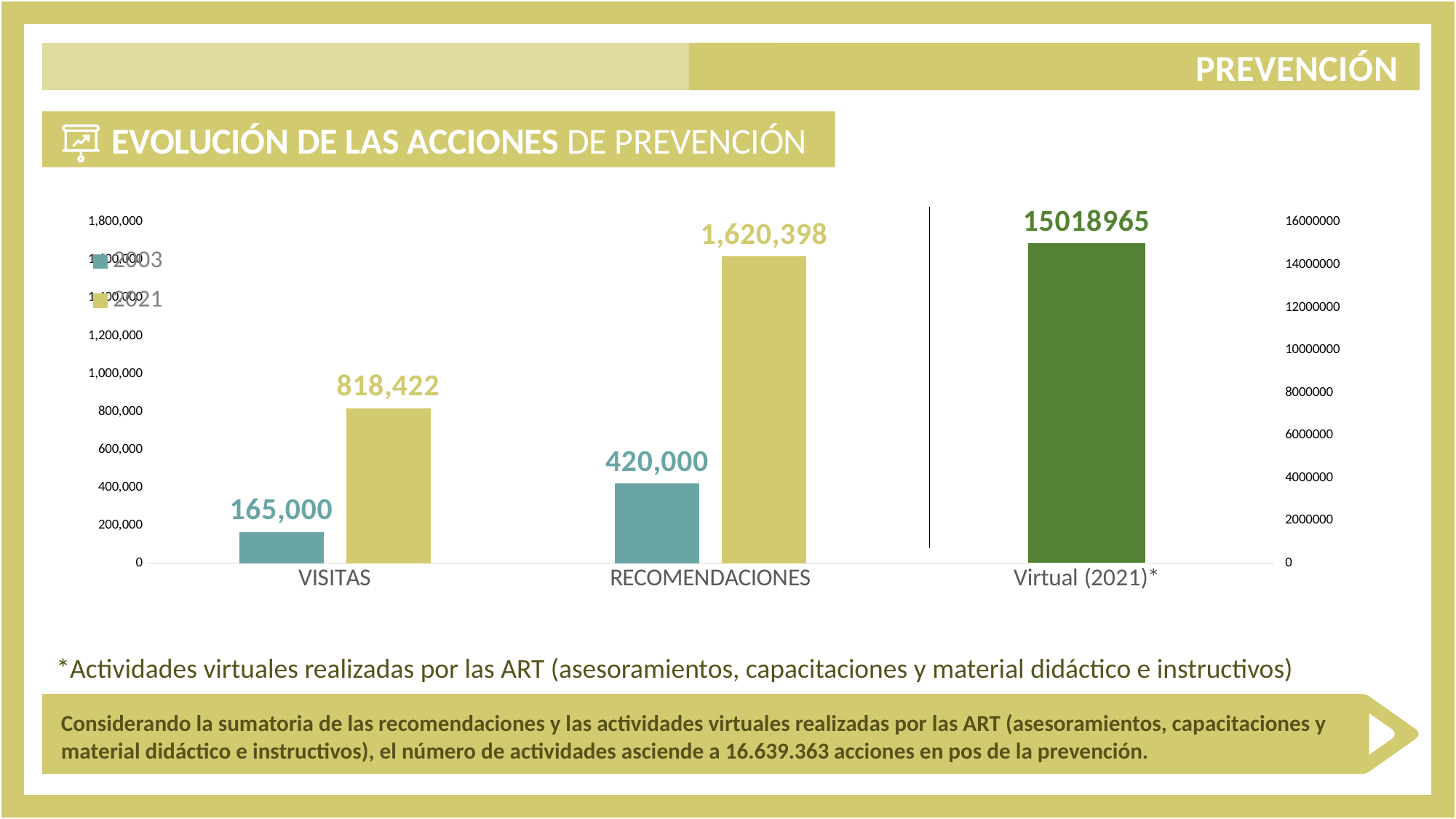
What is the value for RECOMENDACIONES in 2003? 420,000 What is the value shown for Virtual (2021)*? 15018965 Which category has the lowest 2003 value? VISITAS What is the title of the chart section on the slide? EVOLUCIÓN DE LAS ACCIONES DE PREVENCIÓN What kind of chart is shown on the slide? Bar chart How many series does the legend list? 2 What is the value for VISITAS in 2003? 165,000 What is the value for VISITAS in 2021? 818,422 What is the value for RECOMENDACIONES in 2021? 1,620,398 What is the difference between the 2021 and 2003 values for RECOMENDACIONES? 1,200,398 What is the difference between the 2021 and 2003 values for VISITAS? 653,422 Which is larger, the 2003 value for RECOMENDACIONES or the 2021 value for VISITAS? 2021 value for VISITAS